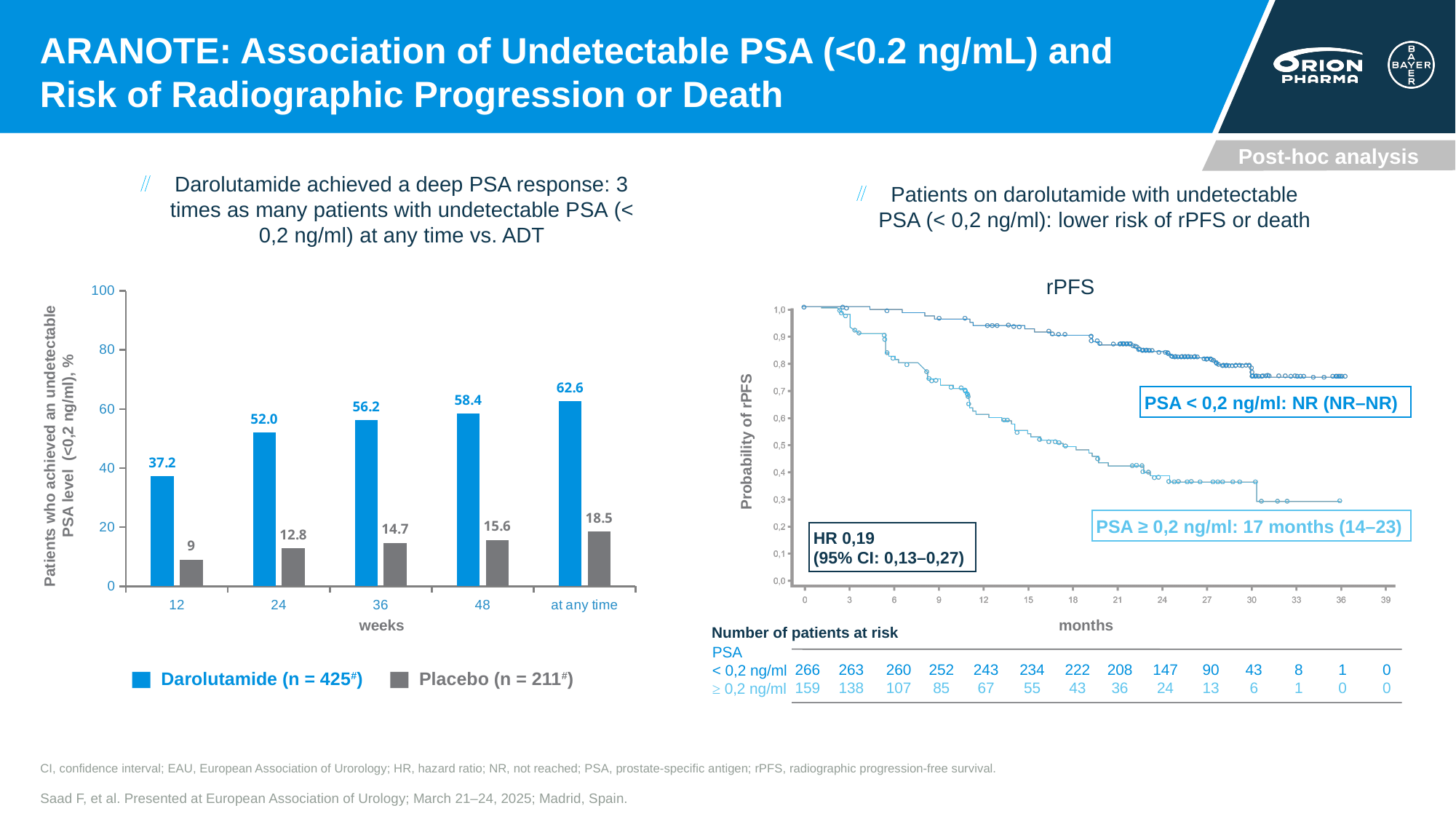
In the rPFS chart on the right, what is the hazard ratio shown in the annotation box? HR 0,19 In the bar chart on the left, what is the value for Darolutamide at any time? 62.6 In the bar chart on the left, which is larger at 36 weeks: Darolutamide or Placebo? Darolutamide In the bar chart on the left, what is the difference between the Darolutamide and Placebo values at 48 weeks? 42.8 In the bar chart on the left, how many time-point categories are shown on the x axis? 5 In the bar chart on the left, what percentage of darolutamide patients achieved an undetectable PSA level at 12 weeks? 37.2 In the bar chart on the left, how many series does the legend list? 2 In the bar chart on the left, at which time point is the Darolutamide value highest? at any time In the bar chart on the left, at which time point is the Placebo value lowest? 12 In the bar chart on the left, do the Darolutamide values rise or fall from 12 weeks to at any time? rise In the bar chart on the left, what is the value for Placebo at 24 weeks? 12.8 In the rPFS chart on the right, is the probability of rPFS for the PSA ≥ 0,2 ng/ml group at 24 months greater or less than 0,5? less